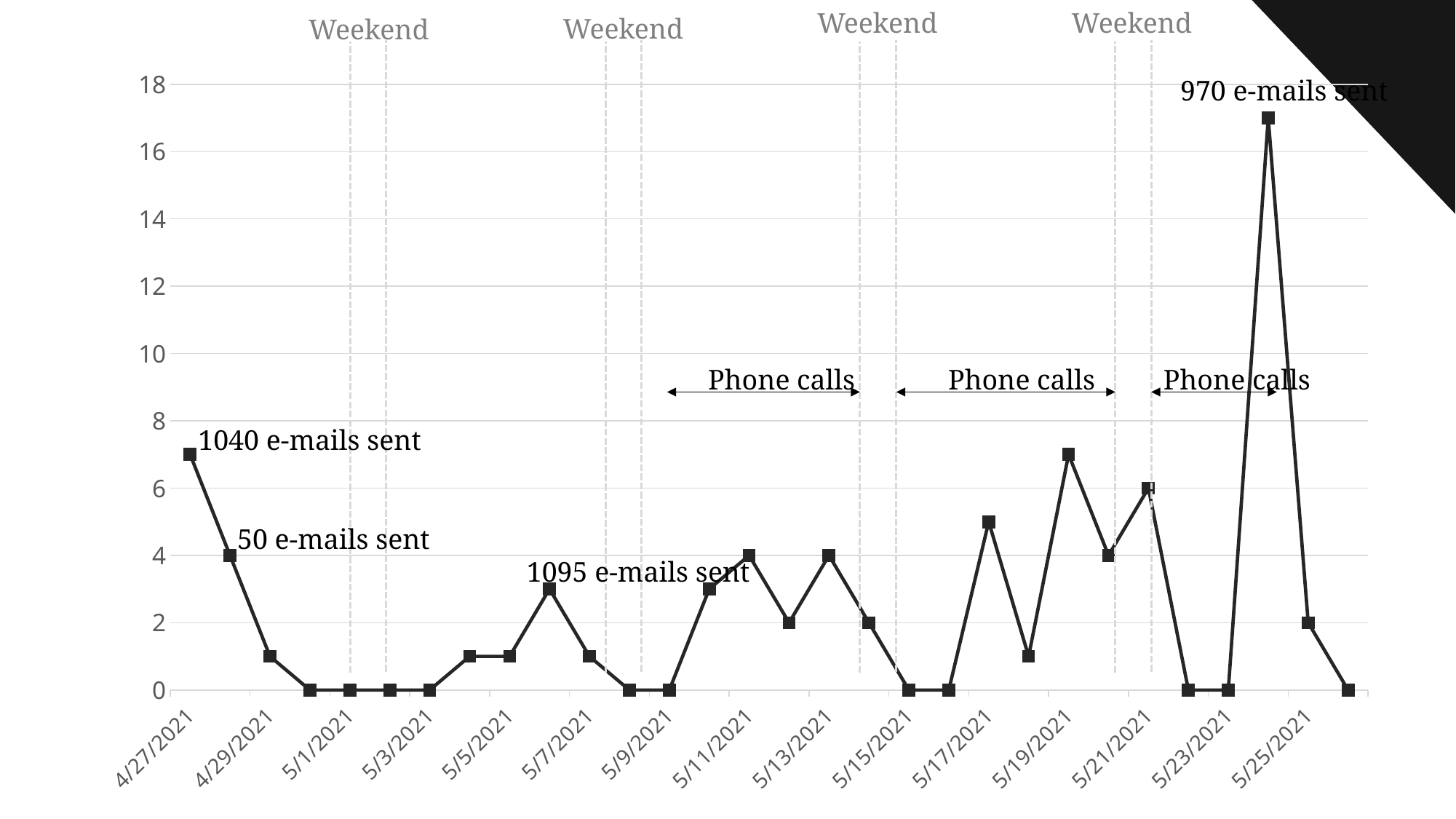
What is the value on 5/1/2021? 0 Is the value on 4/27/2021 greater or less than 6? greater How many e-mails does the annotation at the 5/24/2021 peak say were sent? 970 e-mails sent What is the difference between the values on 5/21/2021 and 5/20/2021? 2 What is the value on 5/21/2021? 6 Does the line rise or fall from 4/27/2021 to 5/1/2021? fall Is the value on 5/24/2021 greater or less than 16? greater Which is larger, the value on 5/19/2021 or the value on 5/17/2021? 5/19/2021 On which date does the line reach its highest value? 5/24/2021 What is the value on 4/28/2021? 4 What type of chart is shown on the slide? line chart How many 'Weekend' labels are marked along the top of the chart? 4